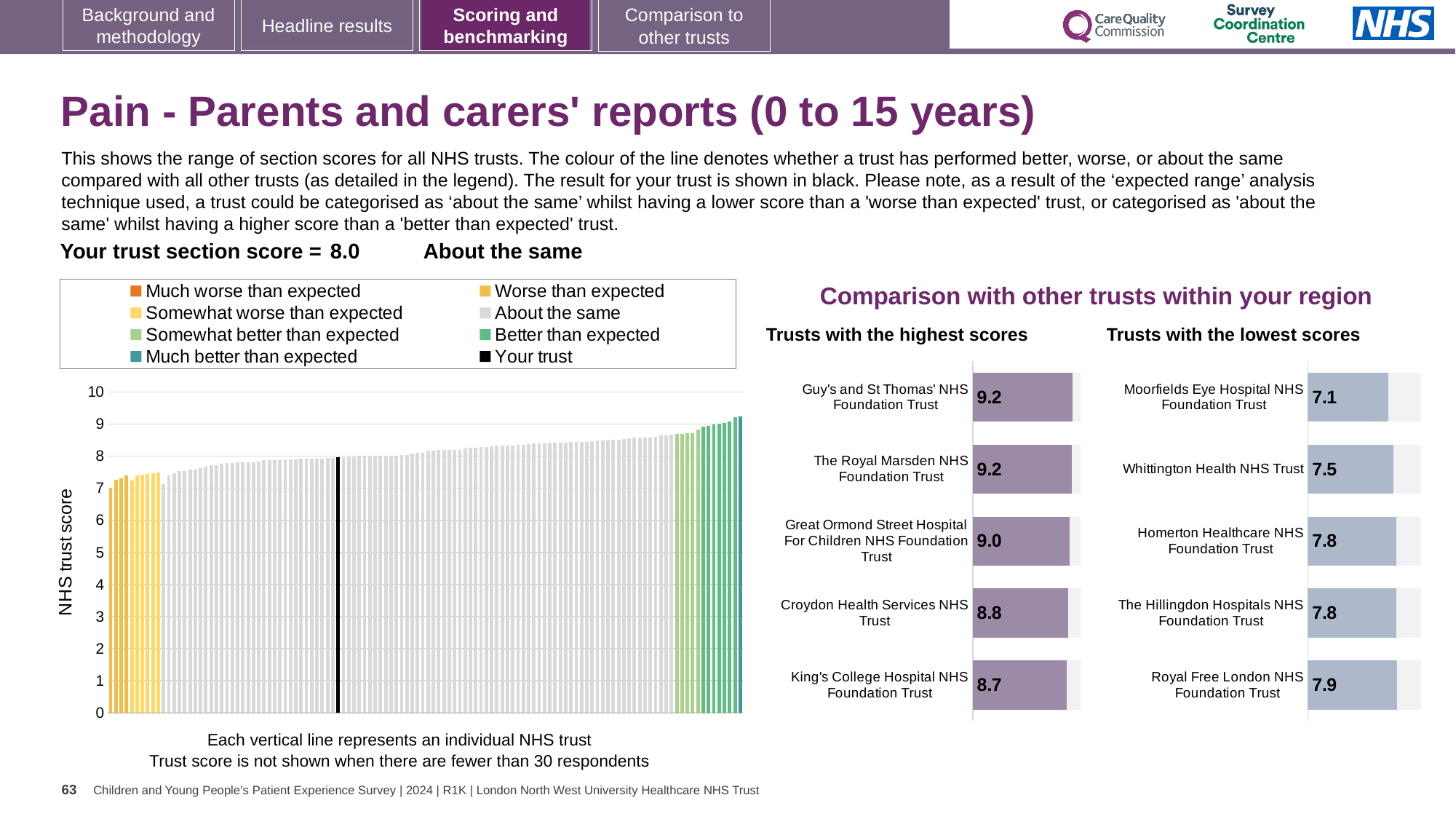
In the 'Trusts with the lowest scores' chart, what is the score for Moorfields Eye Hospital NHS Foundation Trust? 7.1 In the 'Trusts with the lowest scores' chart, which trust has the lowest score? Moorfields Eye Hospital NHS Foundation Trust In the 'Trusts with the highest scores' chart, what is the difference between the scores of Guy's and St Thomas' NHS Foundation Trust and King's College Hospital NHS Foundation Trust? 0.5 In the 'Trusts with the highest scores' chart, what is the score for Croydon Health Services NHS Trust? 8.8 How many trusts are listed in the 'Trusts with the highest scores' chart? 5 In the NHS trust score chart on the left, what colour is the bar for your trust? Black In the 'Trusts with the highest scores' chart, which trust has the lowest score shown? King's College Hospital NHS Foundation Trust How many entries does the legend of the NHS trust score chart on the left list? 8 In the 'Trusts with the lowest scores' chart, which has the higher score: Whittington Health NHS Trust or Homerton Healthcare NHS Foundation Trust? Homerton Healthcare NHS Foundation Trust In the NHS trust score chart on the left, do the bar heights rise or fall from left to right? Rise In the 'Trusts with the lowest scores' chart, how much higher is Royal Free London NHS Foundation Trust's score than Moorfields Eye Hospital NHS Foundation Trust's? 0.8 What kind of chart is the NHS trust score chart on the left of the slide? Bar chart